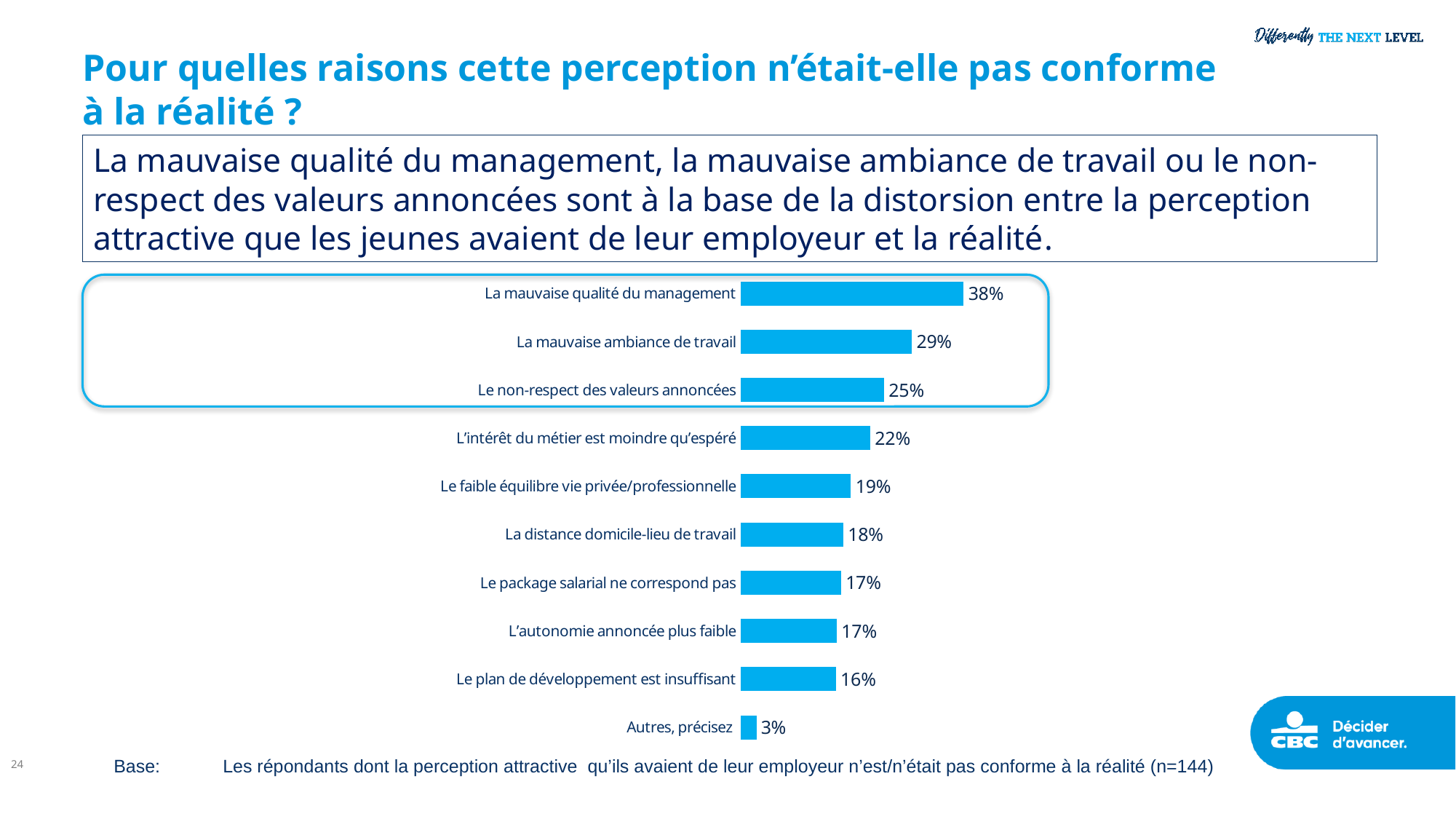
What kind of chart is shown on the slide? Bar chart How many categories are shown in the chart? 10 Which category has the lowest value? Autres, précisez What is the difference between "L'intérêt du métier est moindre qu'espéré" and "Le plan de développement est insuffisant"? 6% Which category has the highest value? La mauvaise qualité du management How many categories are enclosed in the highlighted box at the top of the chart? 3 Which is larger: "La mauvaise ambiance de travail" or "Le faible équilibre vie privée/professionnelle"? La mauvaise ambiance de travail What is the value for "Autres, précisez"? 3% What is the difference between "La mauvaise qualité du management" and "La mauvaise ambiance de travail"? 9% What is the value for "Le non-respect des valeurs annoncées"? 25% What is the value for "La distance domicile-lieu de travail"? 18% What is the value for "La mauvaise qualité du management"? 38%